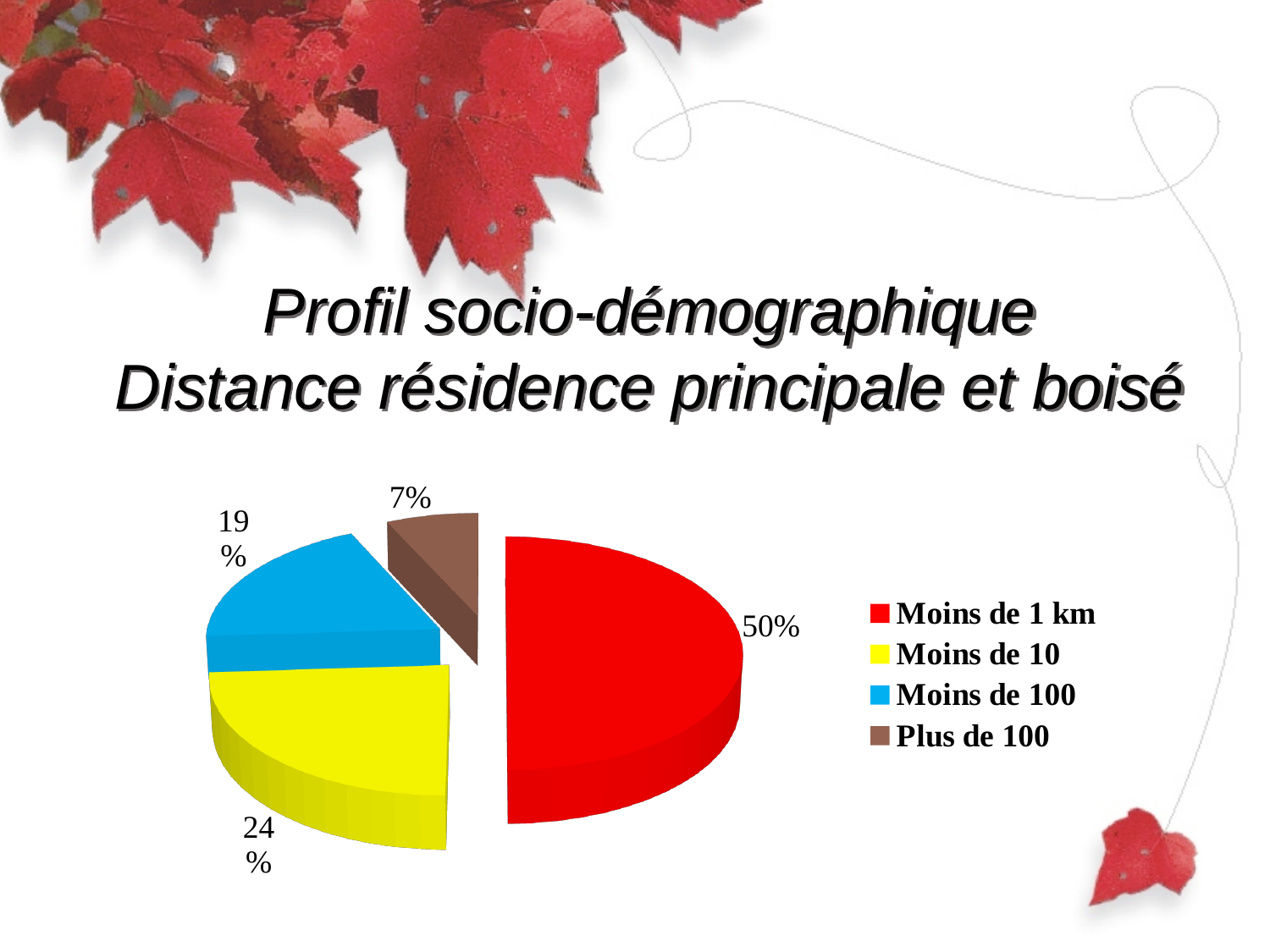
Which category has the largest slice of the pie? Moins de 1 km How many categories does the pie chart show? 4 What share of the pie does "Moins de 1 km" represent? 50% Which category has the smallest slice of the pie? Plus de 100 What kind of chart is shown on the slide? Pie chart What colour is the slice for "Moins de 10"? Yellow What is the value shown for "Plus de 100"? 7% What is the value shown for "Moins de 10"? 24% What is the value shown for "Moins de 100"? 19% Which legend entry is shown in blue? Moins de 100 Which is larger, the share for "Moins de 100" or the share for "Plus de 100"? Moins de 100 What is the difference between the shares of "Moins de 1 km" and "Moins de 10"? 26%